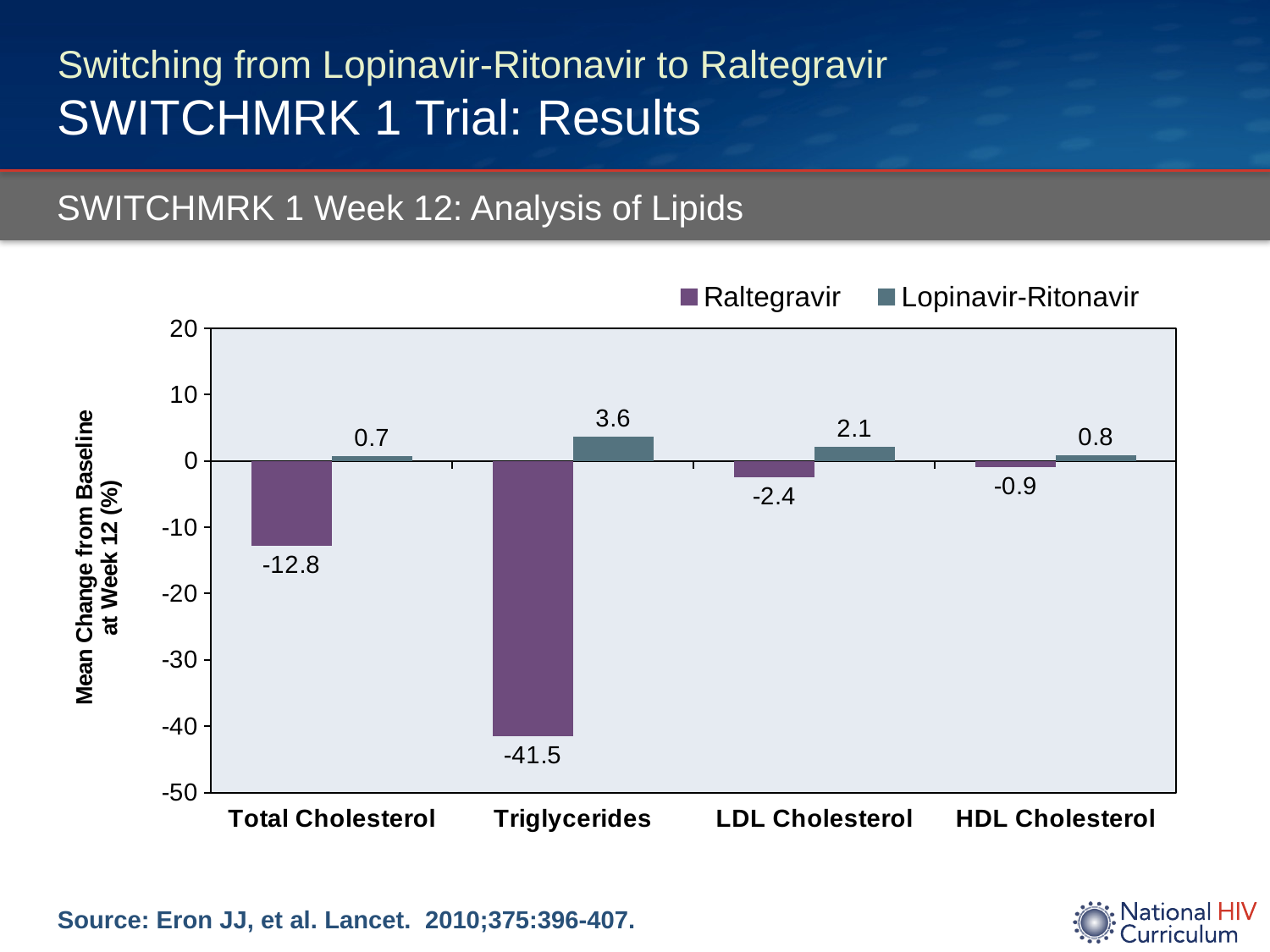
What is the mean change from baseline for Lopinavir-Ritonavir in HDL Cholesterol? 0.8 What is the difference between the Lopinavir-Ritonavir and Raltegravir values for Total Cholesterol? 13.5 Is the Raltegravir value for Triglycerides greater or less than -40? less How many series does the legend list? 2 For which lipid category is the Lopinavir-Ritonavir value highest? Triglycerides What is the mean change from baseline for Lopinavir-Ritonavir in LDL Cholesterol? 2.1 For which lipid category is the Raltegravir value lowest? Triglycerides What is the mean change from baseline for Raltegravir in Total Cholesterol? -12.8 How many lipid categories are shown on the x axis? 4 What kind of chart is shown on the slide? Bar chart What is the mean change from baseline for Raltegravir in Triglycerides? -41.5 Which is larger for LDL Cholesterol, the Raltegravir value or the Lopinavir-Ritonavir value? Lopinavir-Ritonavir